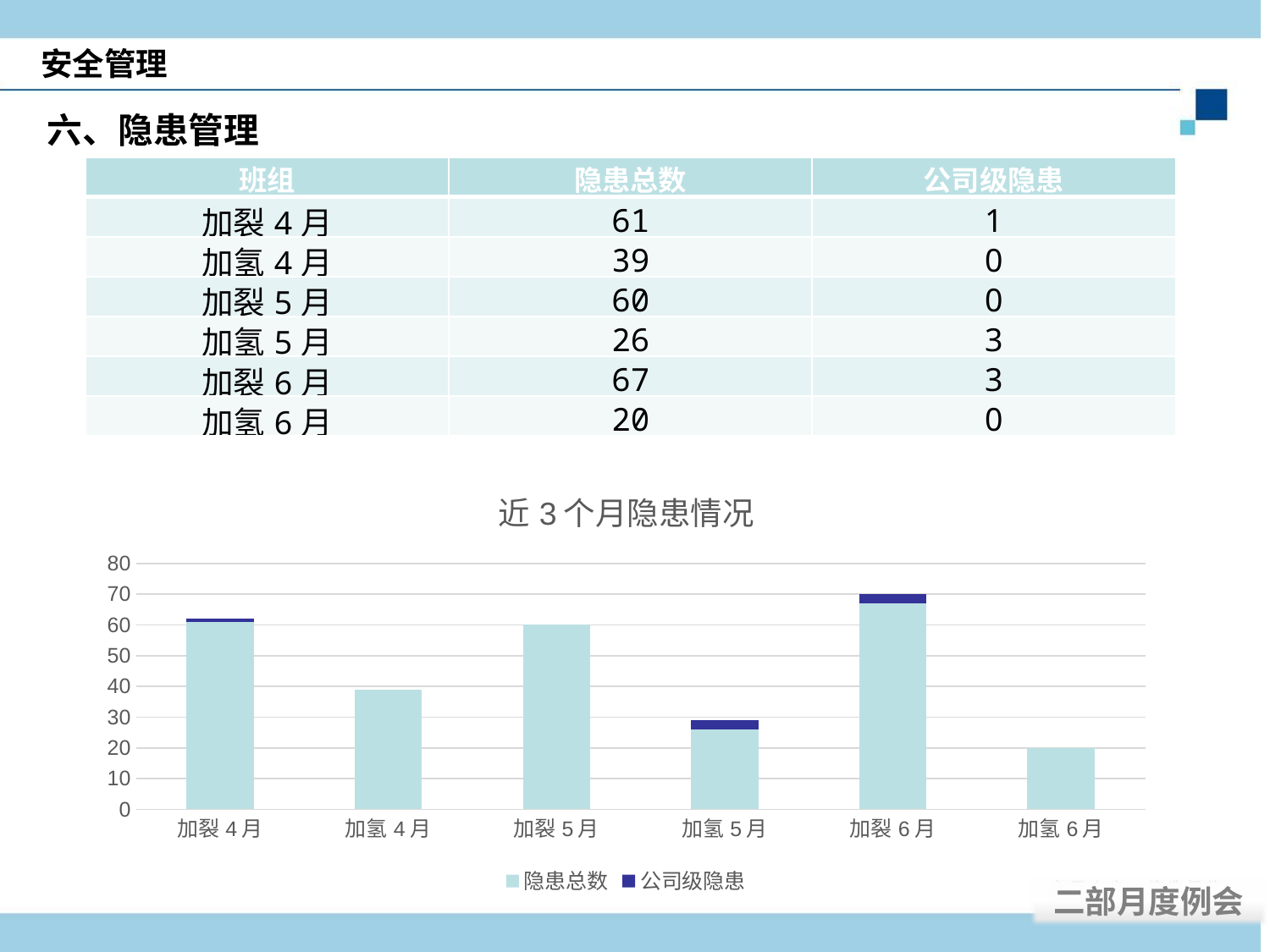
Is the 隐患总数 value for 加氢 5 月 greater or less than 30? less What kind of chart is shown on the slide? bar chart How many categories are shown on the x axis of the chart? 6 What is the title of the chart? 近 3 个月隐患情况 How many series does the chart legend list? 2 What is the 隐患总数 value for 加氢 6 月? 20 What is the difference in 隐患总数 between 加裂 4 月 and 加氢 4 月? 22 Which category has the lowest 隐患总数 in the chart? 加氢 6 月 Which category has the highest 隐患总数 in the chart? 加裂 6 月 What is the 公司级隐患 value for 加氢 5 月? 3 What is the 隐患总数 value for 加裂 5 月? 60 What is the total height of the stacked bar for 加裂 6 月 (隐患总数 plus 公司级隐患)? 70